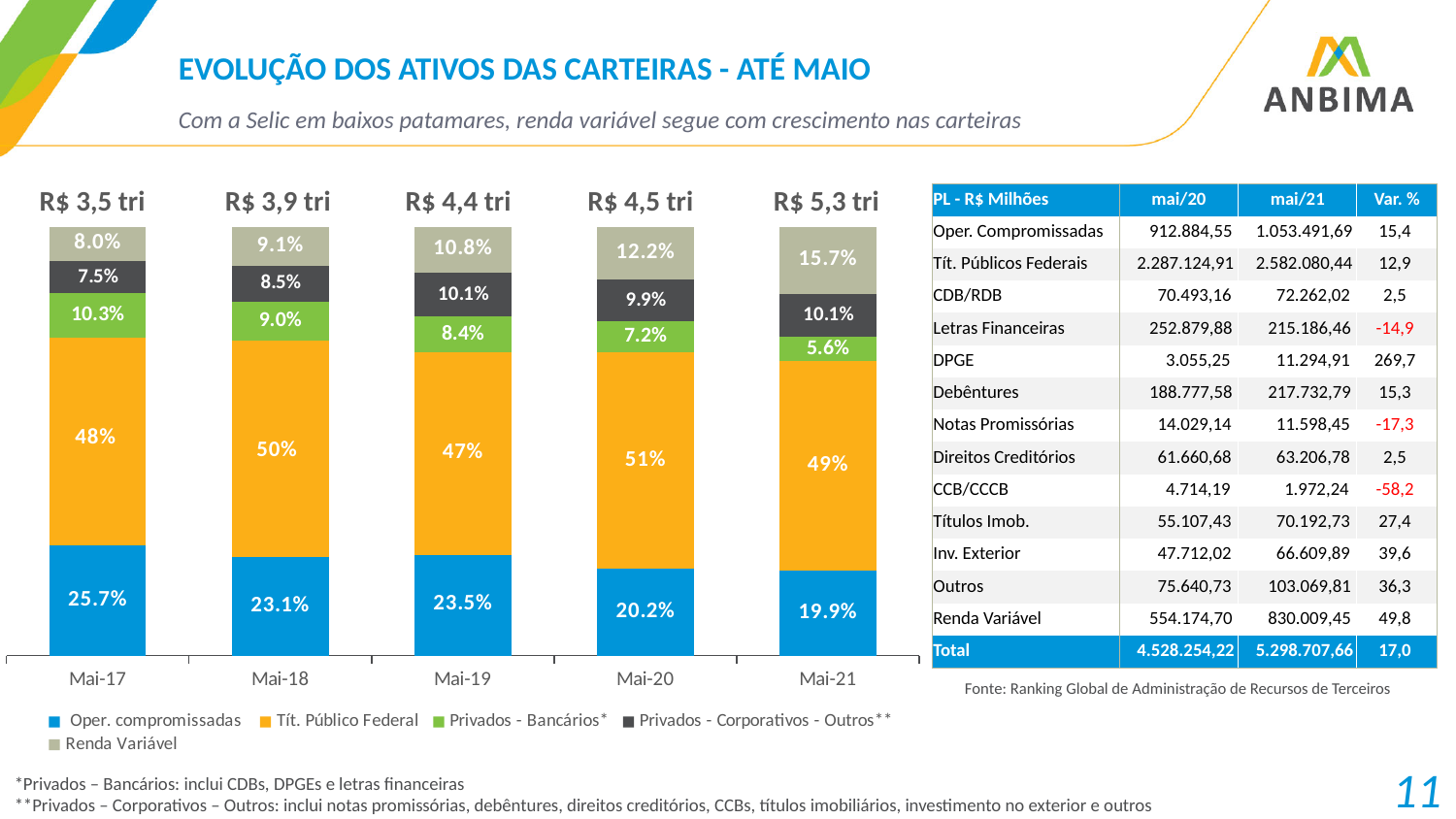
What is the value for Tít. Público Federal in Mai-20? 51% In which year is the Renda Variável share the highest? Mai-21 By how many percentage points did Renda Variável grow from Mai-17 to Mai-21? 7.7 percentage points Which is larger: Privados - Bancários in Mai-17 or in Mai-21? Mai-17 How many years (categories) are shown on the x axis? 5 In which year is the Oper. compromissadas share the lowest? Mai-21 What is the value for Oper. compromissadas in Mai-17? 25.7% How many series does the legend list? 5 What kind of chart is shown? Stacked bar chart What is the value for Renda Variável in Mai-21? 15.7% What total value is printed above the Mai-21 bar? R$ 5,3 tri What is the value for Privados - Bancários in Mai-19? 8.4%